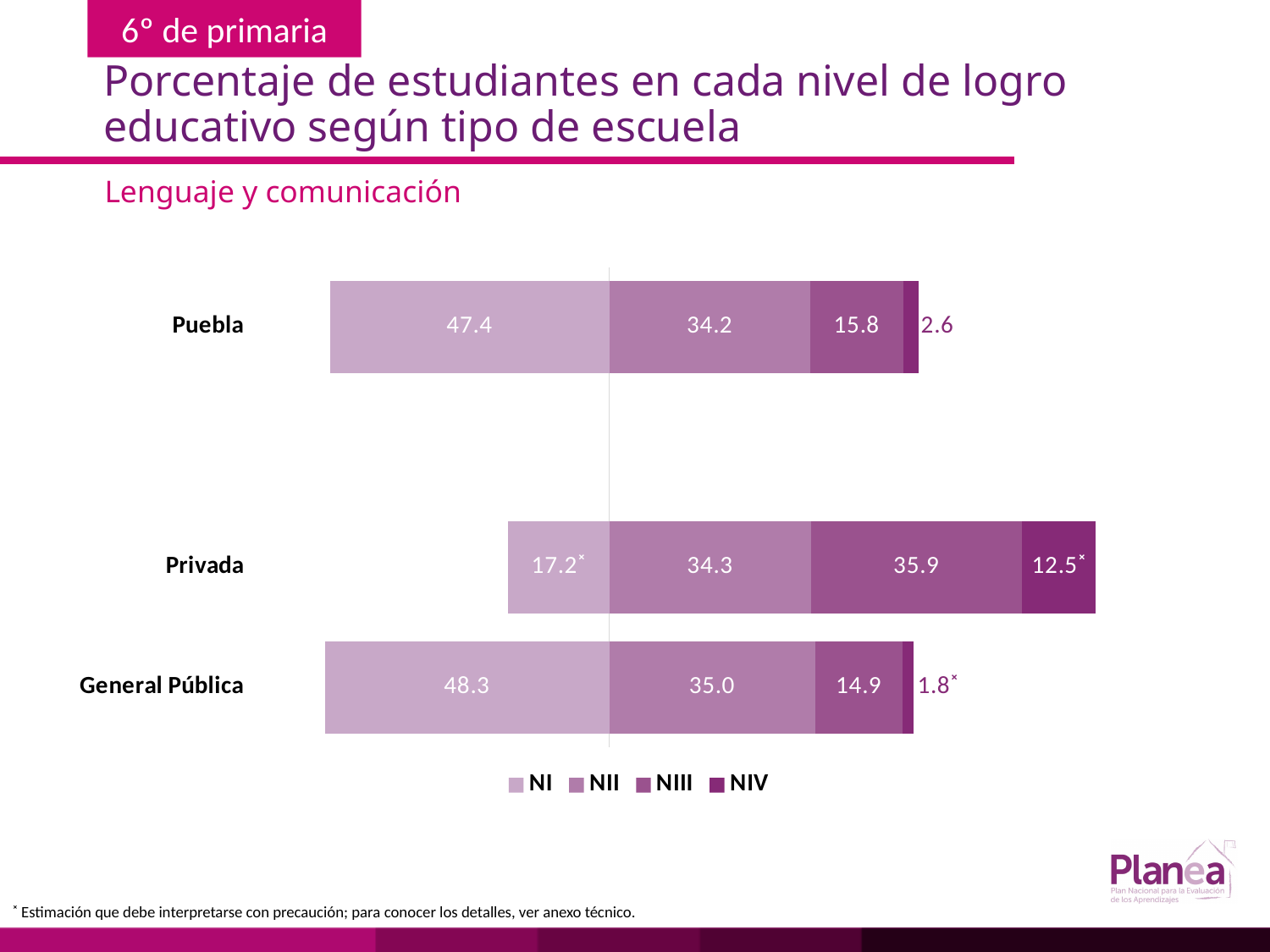
What is the NII value for General Pública? 35.0 What kind of chart is shown on the slide? Stacked bar chart What is the total of the stacked bar for Privada? 99.9 How many school types (categories) are shown in the chart? 3 How many series does the legend list? 4 Which school type has the highest NI percentage? General Pública Which is larger, the NIII value for Puebla or for General Pública? Puebla What is the NIII value for Privada schools? 35.9 Which school type has the lowest NIV percentage? General Pública What is the NIV value for General Pública? 1.8 What percentage of Puebla students are at level NI? 47.4 What is the difference between the NIV values for Privada and Puebla? 9.9